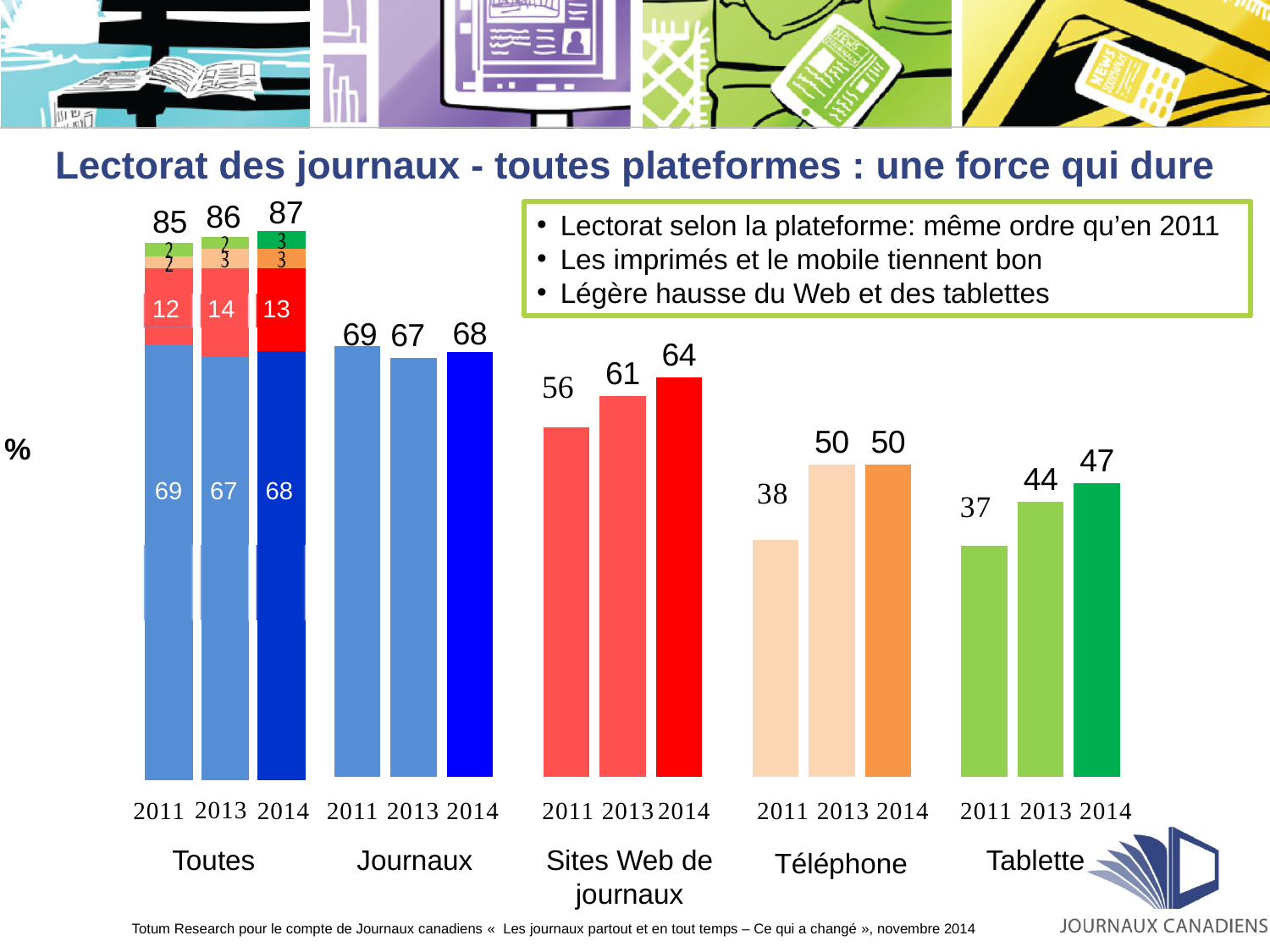
How many platform groups are shown on the chart? 5 Which year has the lowest value for Tablette? 2011 What kind of chart is shown on the slide? bar chart What is the value for Téléphone in 2011? 38 Do the values for Tablette rise or fall from 2011 to 2014? rise Which is larger, the Journaux value for 2011 or the Sites Web de journaux value for 2011? Journaux 2011 What is the total shown above the stacked Toutes bar for 2014? 87 What is the value for Tablette in 2013? 44 What is the difference between the Sites Web de journaux values for 2014 and 2011? 8 Which year has the highest value for Sites Web de journaux? 2014 What is the value for Sites Web de journaux in 2014? 64 What is the difference between the Téléphone values for 2013 and 2011? 12